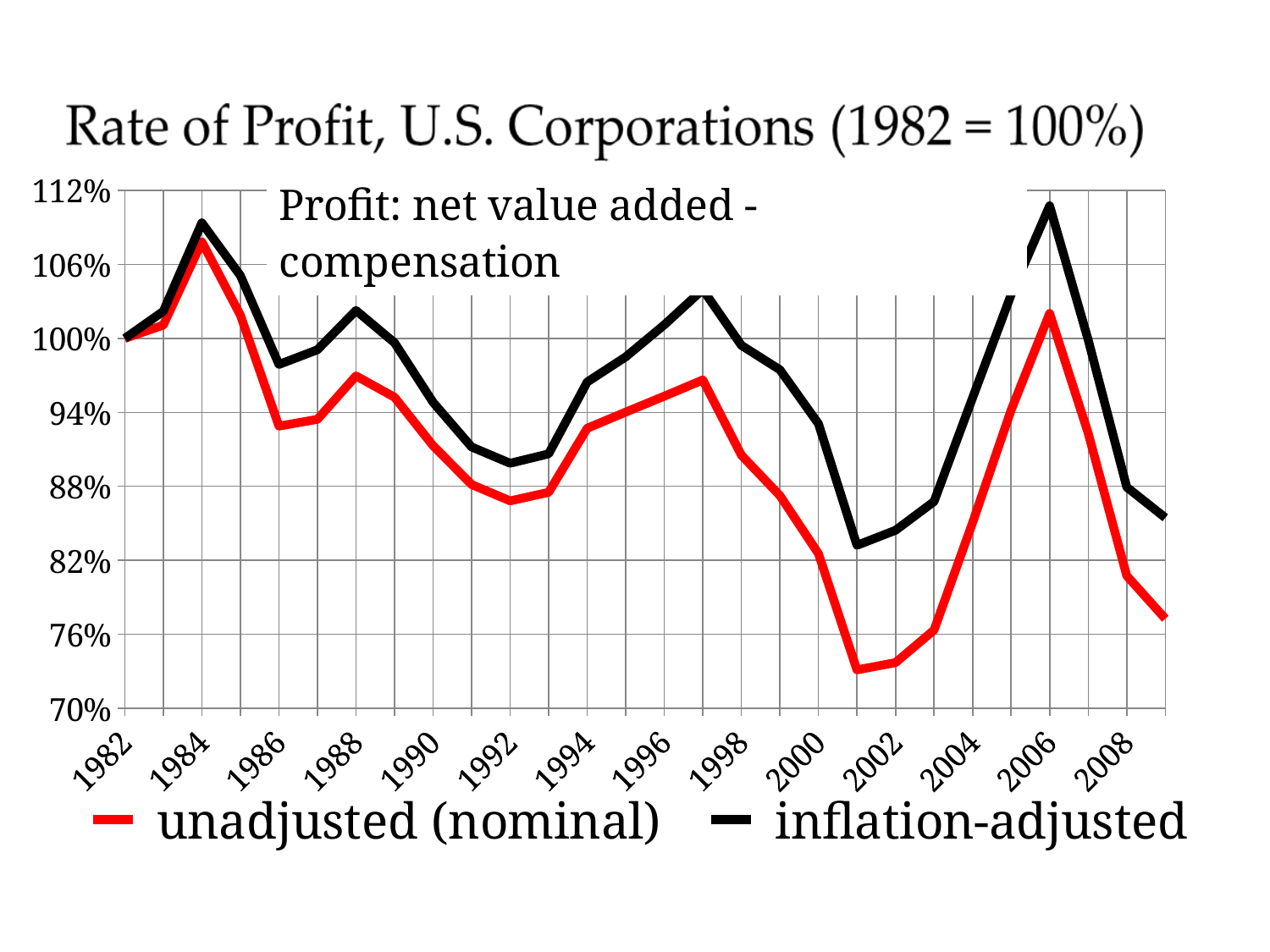
What is the value of the unadjusted (nominal) series in 1982? 100% Which colour is used for the inflation-adjusted series? black How many series does the legend list? 2 Does the unadjusted (nominal) series rise or fall between 1997 and 2001? fall What is the title of the chart? Rate of Profit, U.S. Corporations (1982 = 100%) Is the value of the inflation-adjusted series in 2006 greater or less than 106%? greater In which year does the unadjusted (nominal) series reach its lowest value? 2001 In which year does the unadjusted (nominal) series reach its highest value? 1984 What type of chart is shown on the slide? line chart Which series has the higher value in 2006, unadjusted (nominal) or inflation-adjusted? inflation-adjusted In which year does the inflation-adjusted series reach its lowest value? 2001 Is the value of the unadjusted (nominal) series in 2001 greater or less than 76%? less